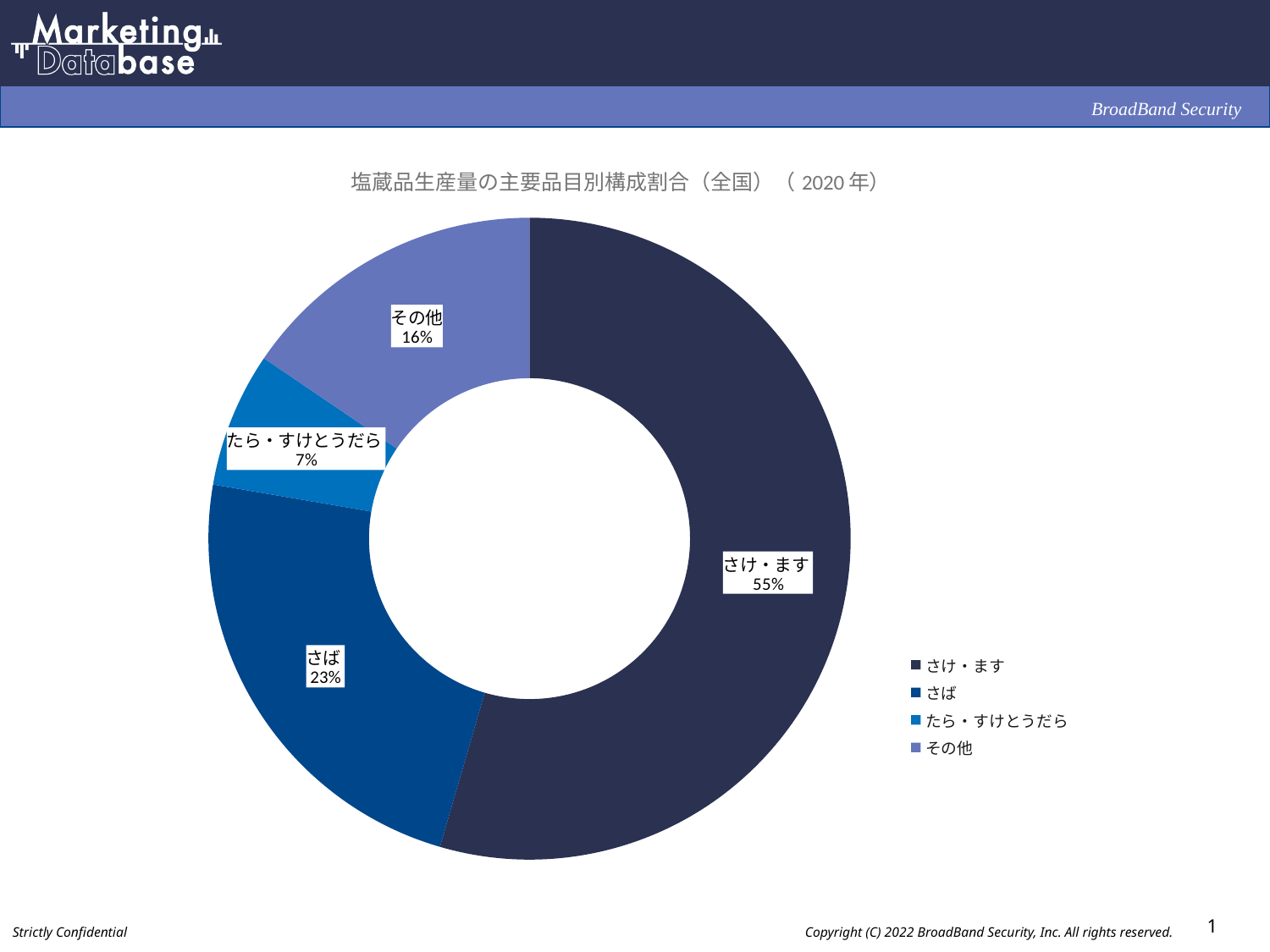
What is the difference in percentage points between その他 and たら・すけとうだら? 9 What kind of chart is shown on the slide? Pie (donut) chart What share of the pie does さけ・ます account for? 55% What share of the pie does その他 represent? 16% Which category has the smallest share of the pie? たら・すけとうだら Which is larger, the share for さば or the share for その他? さば What is the title of the chart? 塩蔵品生産量の主要品目別構成割合（全国）（2020年） Which category has the largest share of the pie? さけ・ます What is the difference in percentage points between さけ・ます and さば? 32 What is the value shown for さば? 23% What percentage is labelled for たら・すけとうだら? 7% How many categories are shown in the chart? 4